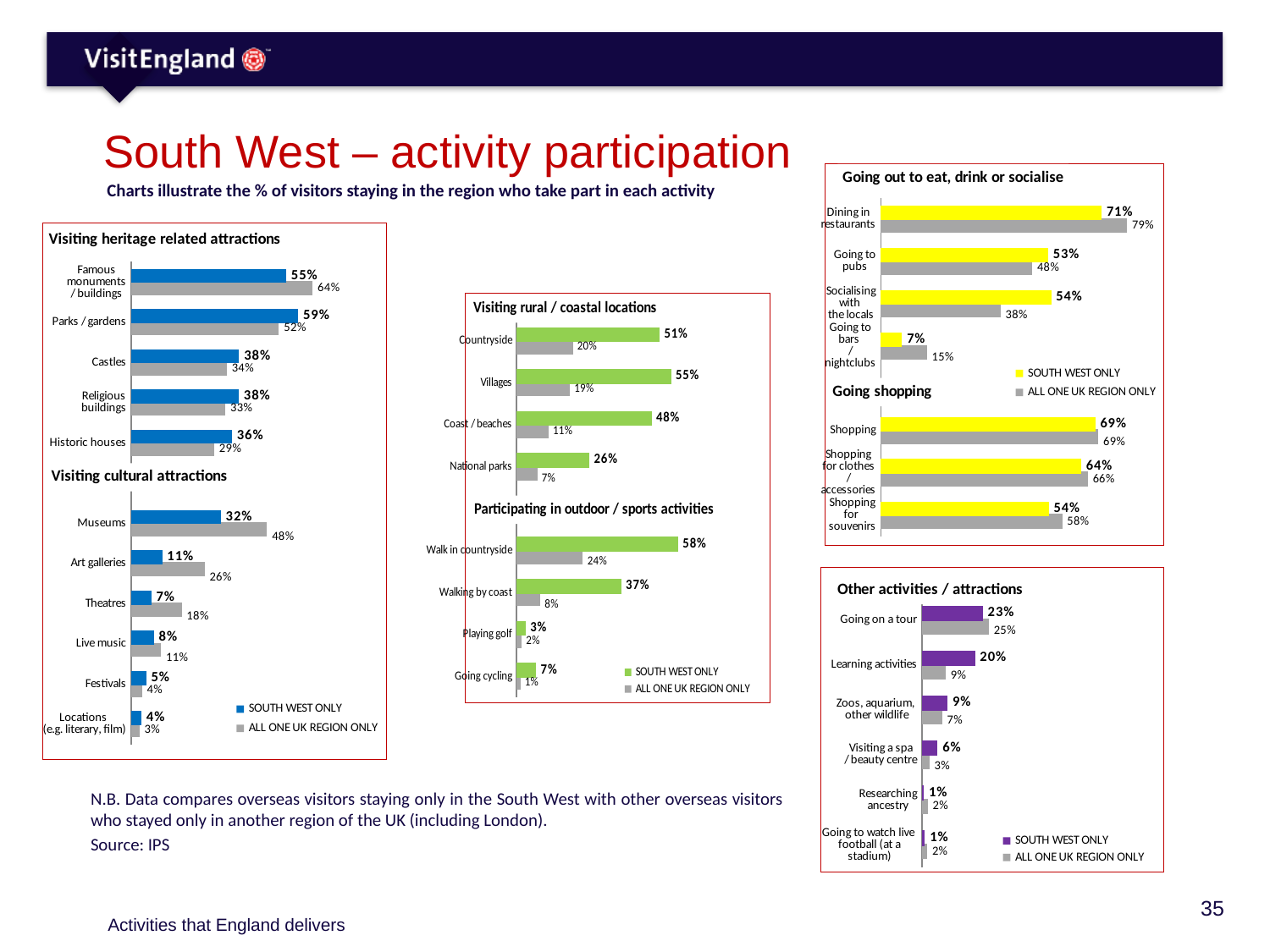
In the 'Visiting cultural attractions' chart, what is the difference between the All one UK region only and South West only values for Museums? 16% In the 'Going out to eat, drink or socialise' chart, which is larger for Dining in restaurants: South West only or All one UK region only? All one UK region only In the 'Visiting rural / coastal locations' chart, which category has the highest South West only value? Villages How many series does the legend list in the 'Other activities / attractions' chart? 2 In the 'Visiting heritage related attractions' chart, what is the All one UK region only value for Famous monuments / buildings? 64% In the 'Participating in outdoor / sports activities' chart, how many categories are shown? 4 In the 'Going out to eat, drink or socialise' chart, what is the South West only value for Going to bars / nightclubs? 7% In the 'Visiting cultural attractions' chart, which category has the highest South West only value? Museums In the 'Other activities / attractions' chart, what is the difference between the South West only and All one UK region only values for Learning activities? 11% In the 'Participating in outdoor / sports activities' chart, what is the South West only value for Walking by coast? 37% In the 'Visiting heritage related attractions' chart, what is the South West only value for Parks / gardens? 59% In the 'Visiting rural / coastal locations' chart, what is the All one UK region only value for Coast / beaches? 11%